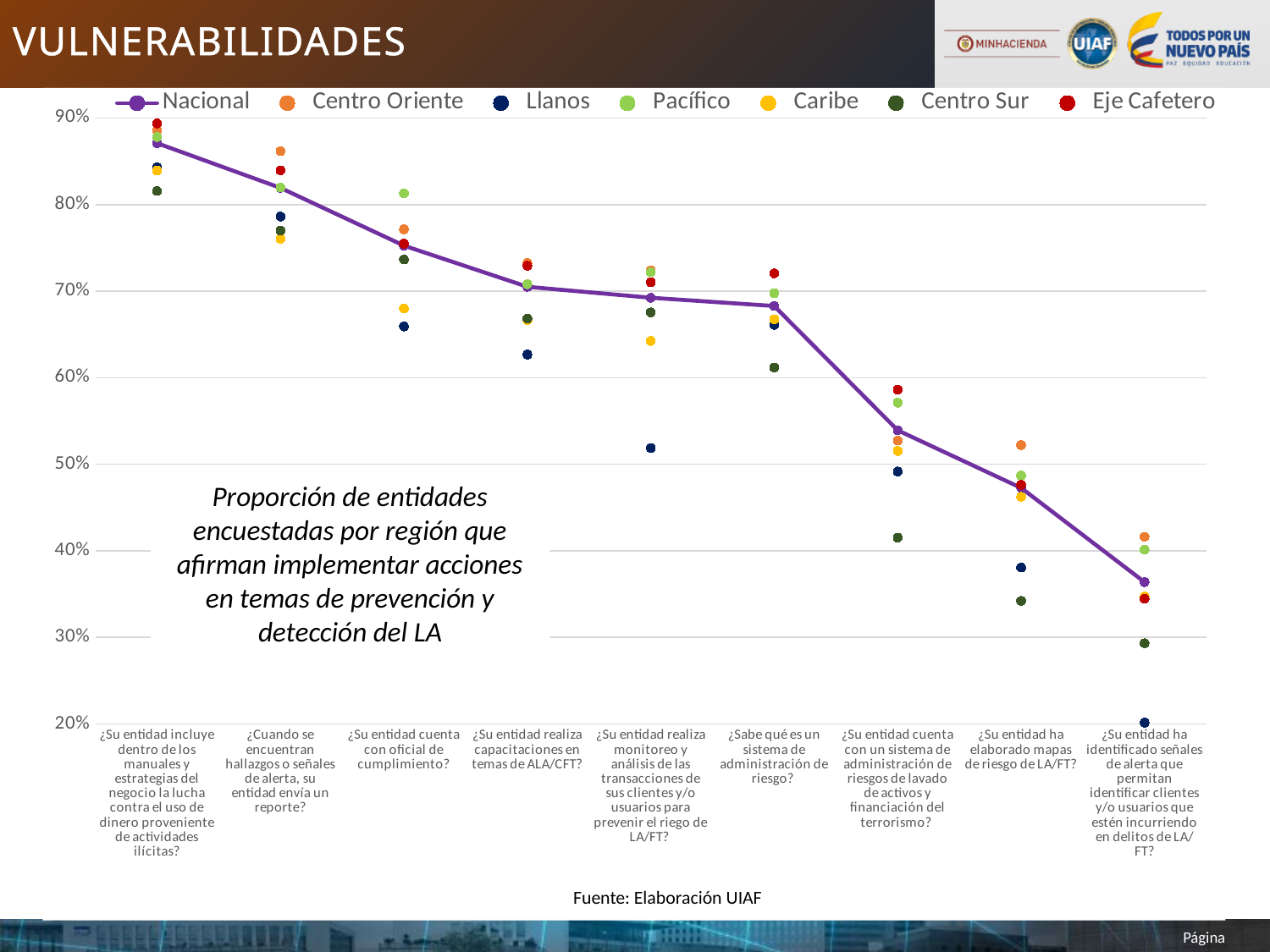
Does the Nacional line rise or fall from left to right along the x axis? Falls For '¿Su entidad cuenta con oficial de cumplimiento?', which is larger: the Pacífico value or the Llanos value? Pacífico What colour is used for the Nacional series in the legend? Purple How many series does the legend list? 7 For '¿Su entidad ha identificado señales de alerta que permitan identificar clientes y/o usuarios que estén incurriendo en delitos de LA/FT?', which is larger: the Centro Oriente value or the Llanos value? Centro Oriente Is the Nacional value for '¿Su entidad incluye dentro de los manuales y estrategias del negocio la lucha contra el uso de dinero proveniente de actividades ilícitas?' greater or less than 80%? greater Which category has the lowest Nacional value? ¿Su entidad ha identificado señales de alerta que permitan identificar clientes y/o usuarios que estén incurriendo en delitos de LA/FT? Which category has the highest Nacional value? ¿Su entidad incluye dentro de los manuales y estrategias del negocio la lucha contra el uso de dinero proveniente de actividades ilícitas? Is the Nacional value for '¿Su entidad ha identificado señales de alerta que permitan identificar clientes y/o usuarios que estén incurriendo en delitos de LA/FT?' greater or less than 40%? less Is the Llanos value for '¿Su entidad realiza monitoreo y análisis de las transacciones de sus clientes y/o usuarios para prevenir el riego de LA/FT?' greater or less than 60%? less What kind of chart is shown on the slide? Line chart with scatter points How many question categories are plotted along the x axis? 9